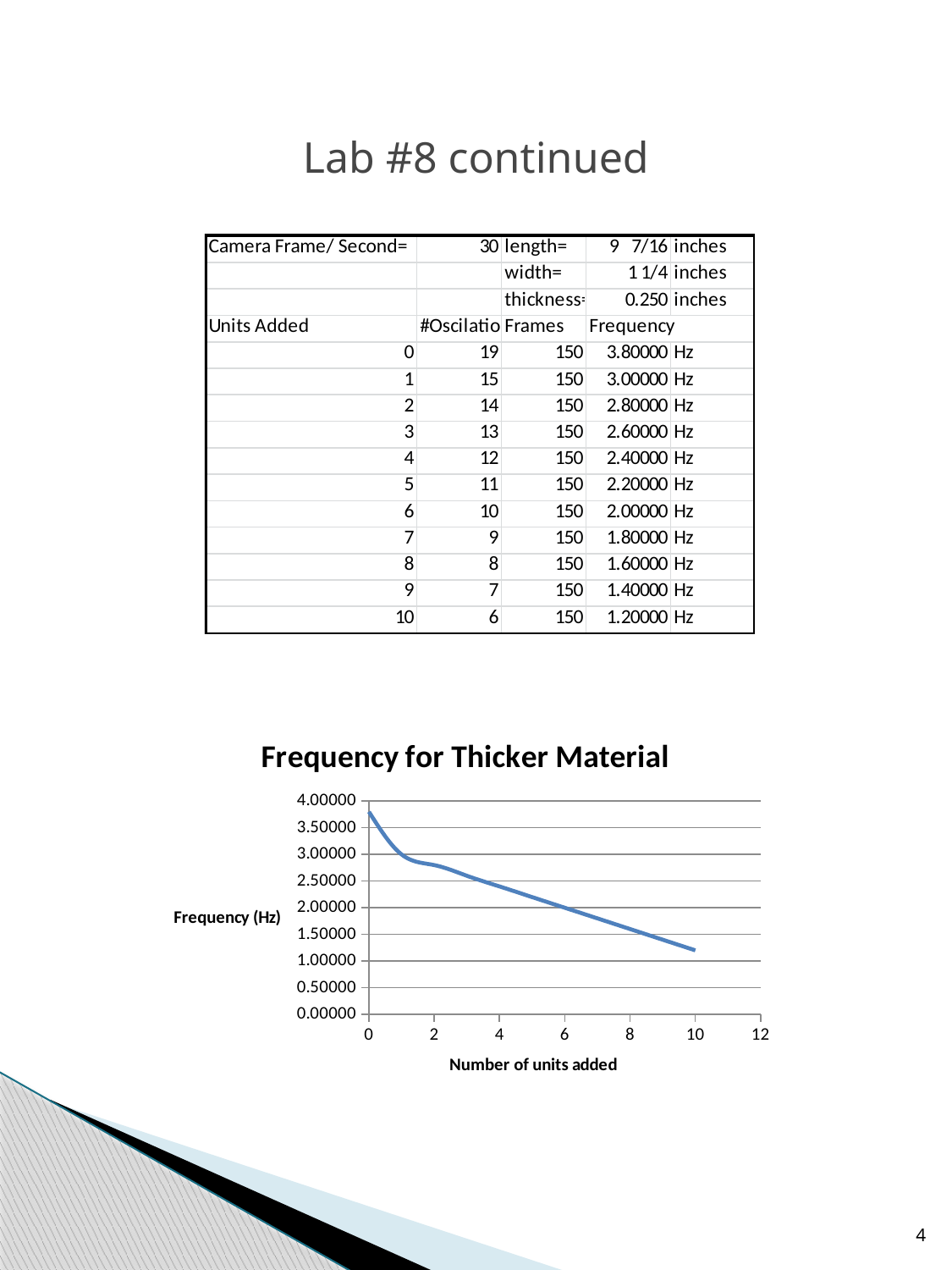
Is the frequency at 10 units added greater or less than 1.50000? less What kind of chart is shown under the title "Frequency for Thicker Material"? line chart What is the title of the chart on the slide? Frequency for Thicker Material Is the frequency at 0 units added greater or less than 3.50000? greater Does the frequency rise or fall as the number of units added increases? fall What is the label on the x axis of the chart? Number of units added Which is larger, the frequency at 2 units added or at 8 units added? 2 units added What is the frequency at 1 unit added? 3.00000 At which number of units added is the frequency highest? 0 At which number of units added is the frequency lowest? 10 Is the frequency at 8 units added greater or less than 2.00000? less What is the frequency at 6 units added? 2.00000